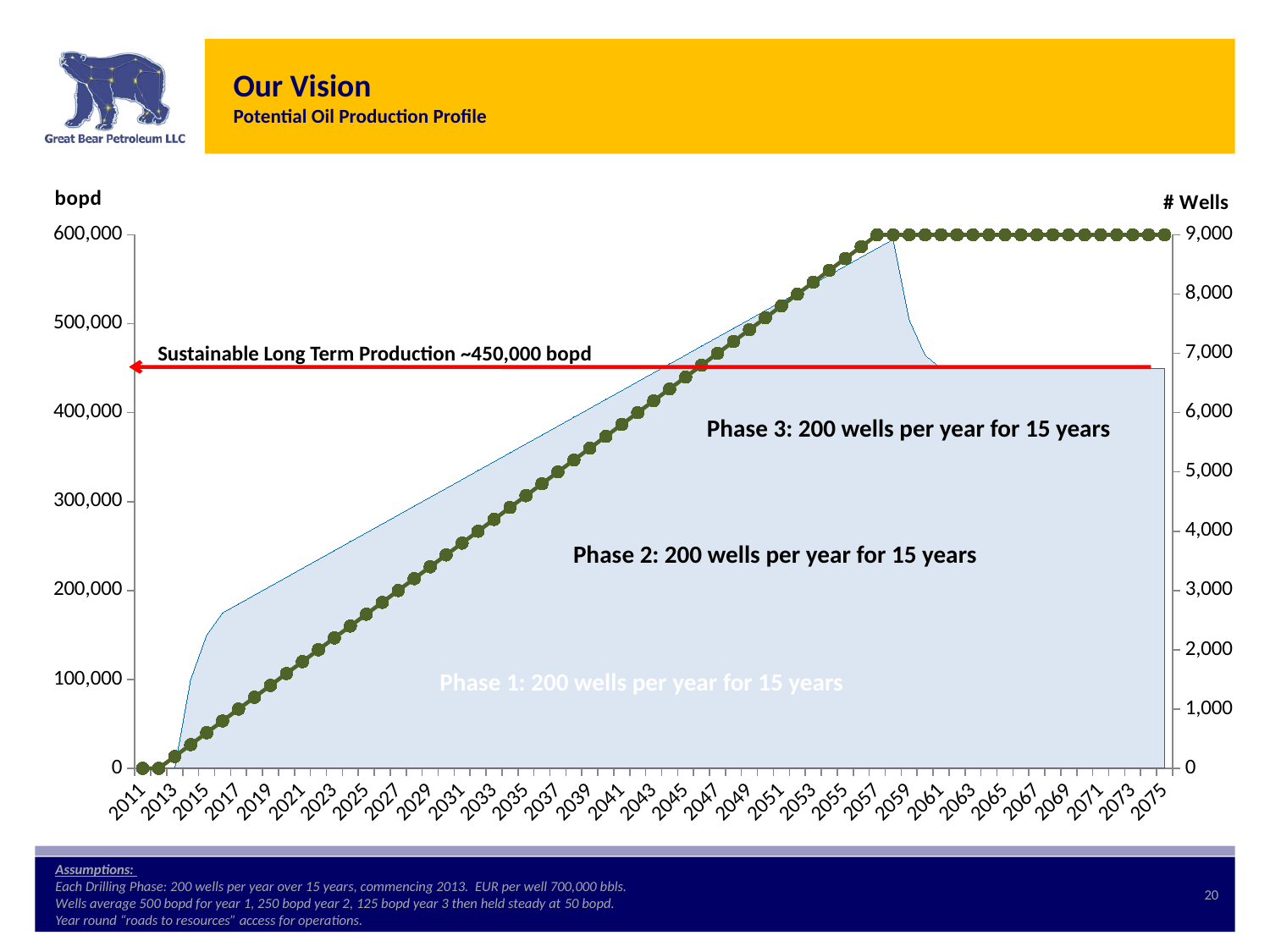
What is the label of the right vertical axis? # Wells What is the number of wells shown for 2011? 0 Is the oil production (bopd) in 2017 greater or less than 200,000? less Is the oil production (bopd) in 2075 greater or less than 400,000? greater What kind of chart is used to plot the # Wells series? line chart What is the title of the chart on the slide? Potential Oil Production Profile At what value does the # Wells line level off from about 2057 onward? 9,000 What is the first year shown on the x axis? 2011 Does the # Wells line rise or fall between 2013 and 2057? rise Is the number of wells in 2040 greater or less than 5,000? greater